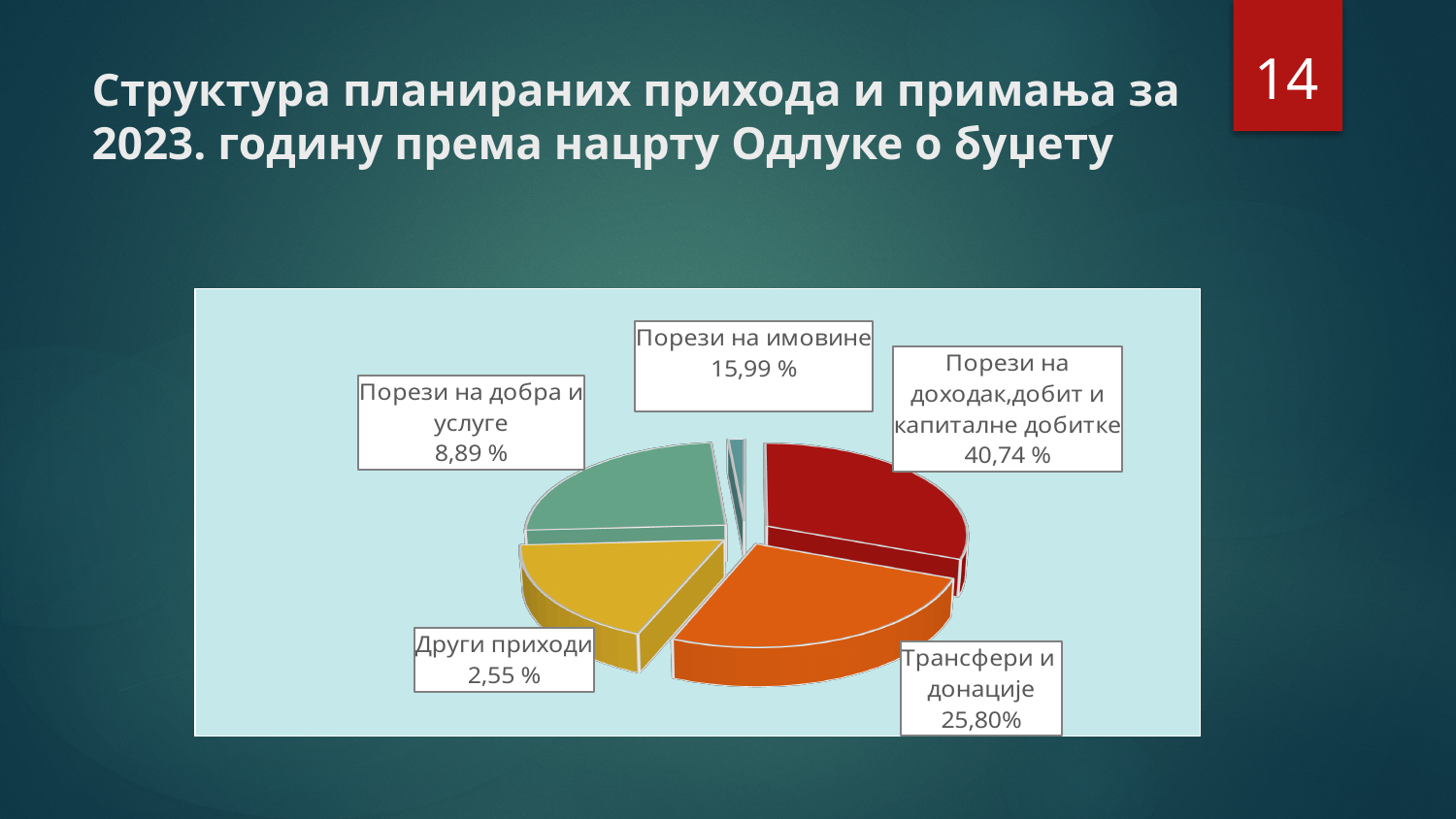
Which is larger: the share for "Трансфери и донације" or the share for "Порези на имовине"? Трансфери и донације What is the title of the slide containing the pie chart? Структура планираних прихода и примања за 2023. годину према нацрту Одлуке о буџету What value is shown for "Трансфери и донације"? 25,80% Which labelled category has the smallest share of the pie? Други приходи What is the difference in percentage points between "Порези на добра и услуге" (8,89 %) and "Други приходи" (2,55 %)? 6,34 What is the difference in percentage points between "Порези на доходак,добит и капиталне добитке" (40,74 %) and "Трансфери и донације" (25,80%)? 14,94 Which labelled category has the largest share of the pie? Порези на доходак,добит и капиталне добитке What value is shown for "Порези на добра и услуге"? 8,89 % What kind of chart is shown on the slide? pie chart What value is shown for "Други приходи"? 2,55 % What value is shown for "Порези на имовине"? 15,99 % What share of planned revenues is labelled for "Порези на доходак,добит и капиталне добитке"? 40,74 %